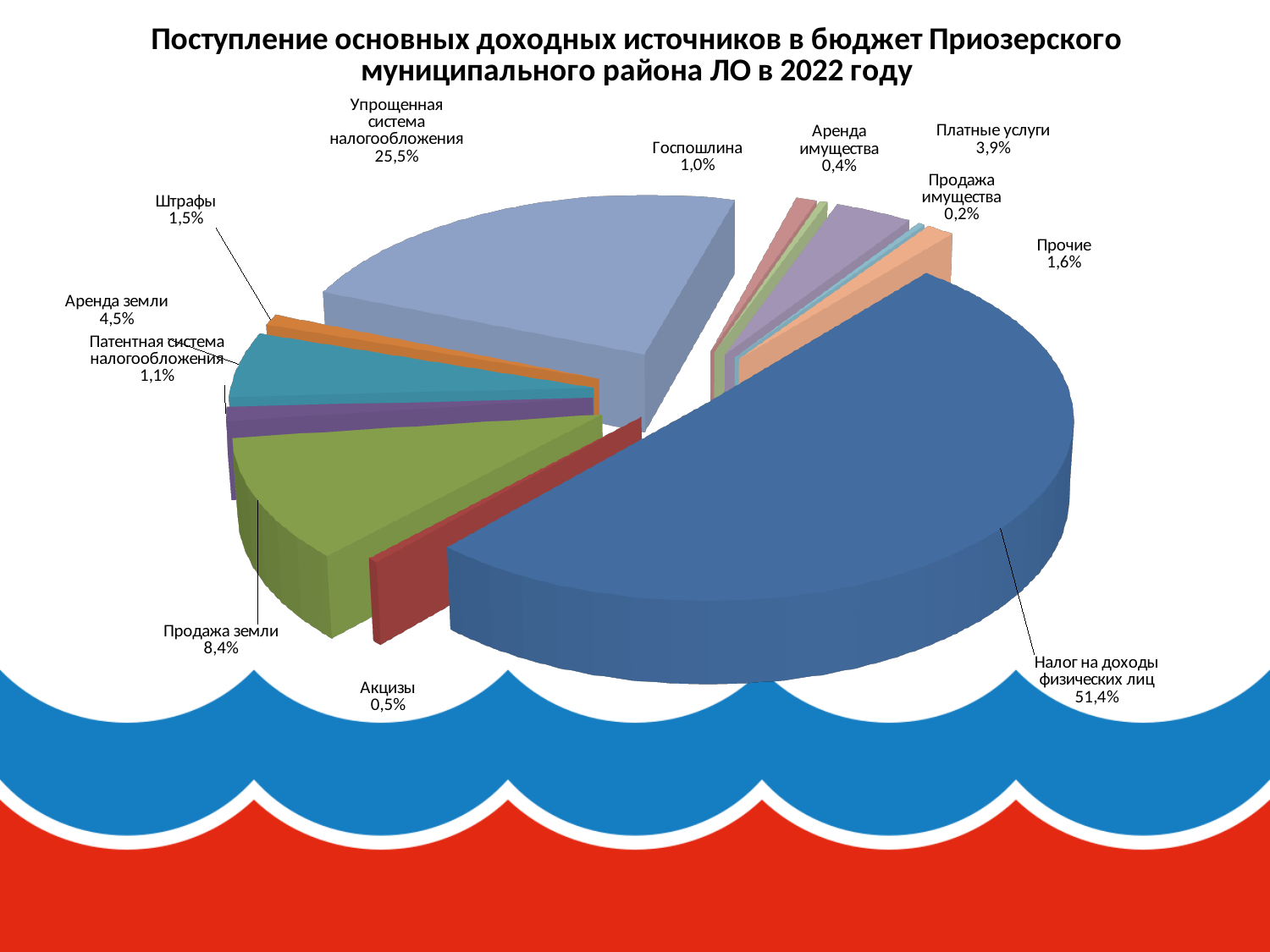
На сколько процентных пунктов доля «Налога на доходы физических лиц» больше доли «Упрощенной системы налогообложения»? 25,9 Какой год указан в заголовке диаграммы? 2022 Какую долю составляют «Акцизы»? 0,5% Что больше: доля «Аренды земли» или доля «Платных услуг»? Аренда земли Какую долю составляет «Упрощенная система налогообложения»? 25,5% Какой источник дохода имеет наибольшую долю? Налог на доходы физических лиц Сколько категорий (источников дохода) показано на диаграмме? 12 Какую долю составляет «Продажа земли»? 8,4% Какой источник дохода имеет наименьшую долю? Продажа имущества Какую долю составляют «Платные услуги»? 3,9% Какую долю составляет «Налог на доходы физических лиц»? 51,4% Какой тип диаграммы показан на слайде? Круговая диаграмма